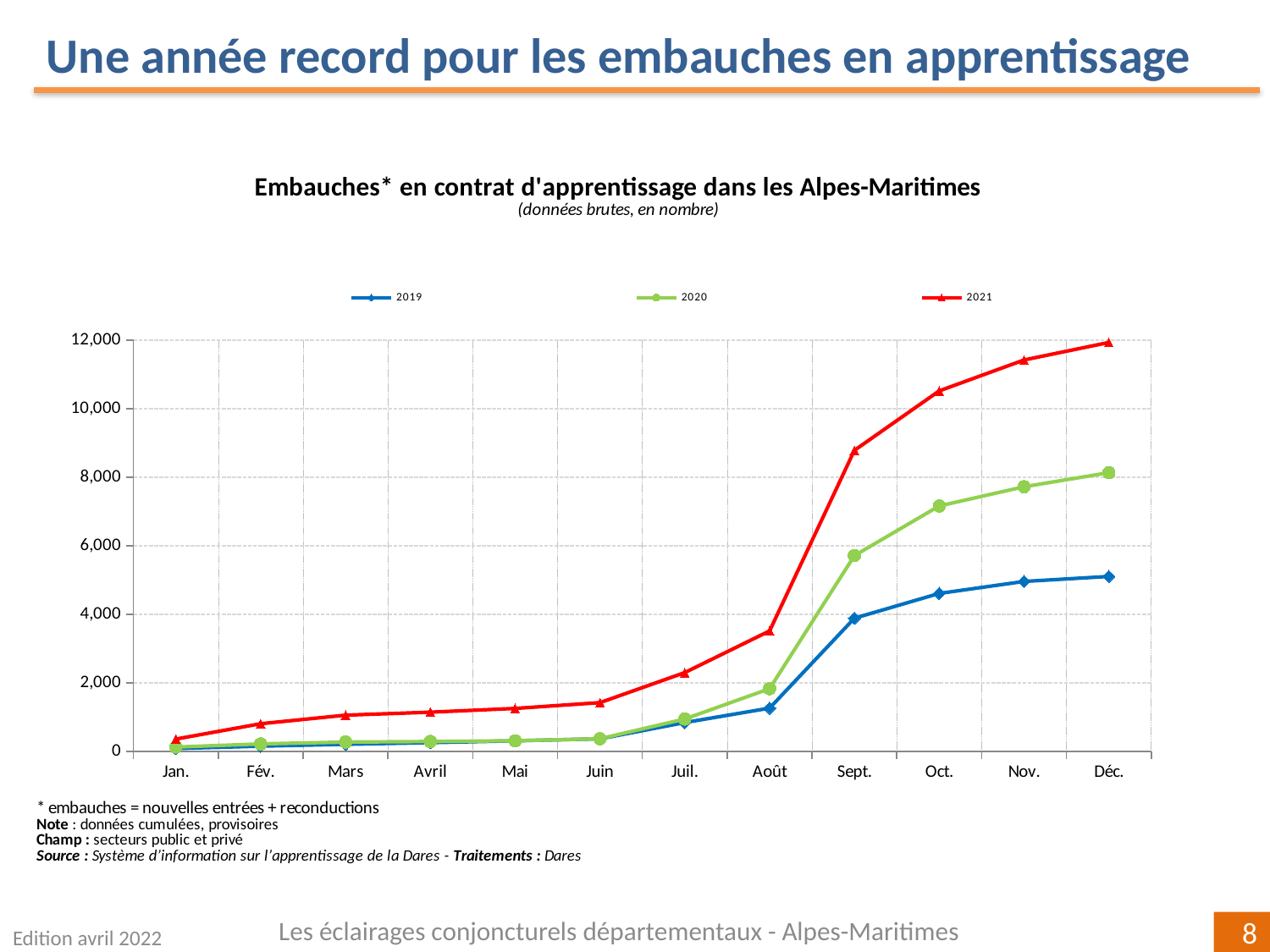
Which series has the lowest value in Déc.? 2019 Which series has the highest value in Déc.? 2021 Is the value for 2019 in Déc. greater or less than 6,000? less In Sept., which series has the larger value, 2020 or 2021? 2021 Is the value for 2021 in Déc. greater or less than 10,000? greater Do the values for the 2021 series rise or fall from Jan. to Déc.? rise How many months are shown along the x axis? 12 Is the value for 2021 in Août greater or less than 4,000? less How many series does the legend list? 3 What kind of chart is shown on the slide? line chart What is the title of the chart? Embauches* en contrat d'apprentissage dans les Alpes-Maritimes